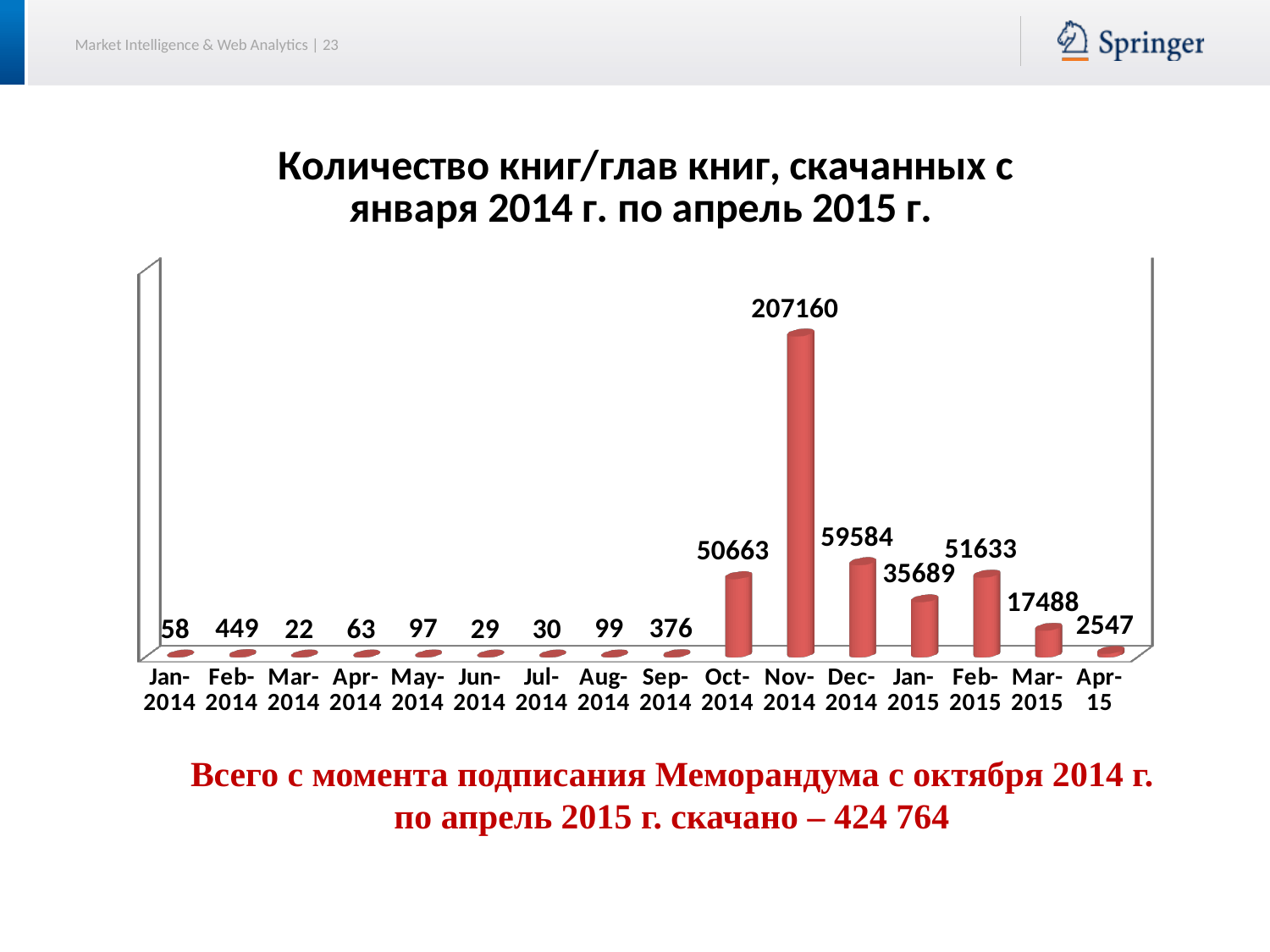
What kind of chart is shown on the slide? Bar chart Do the values rise or fall from Dec-2014 to Apr-15 overall? Fall Which month has the lowest value? Mar-2014 What is the difference between the values for Dec-2014 and Jan-2015? 23895 What is the value for Nov-2014? 207160 What is the difference between the values for Nov-2014 and Oct-2014? 156497 Which is larger, the value for Feb-2015 or the value for Oct-2014? Feb-2015 What is the value for Oct-2014? 50663 What is the value for Apr-15? 2547 How many months are shown on the x axis? 16 What is the value for Feb-2015? 51633 Which month has the highest value? Nov-2014